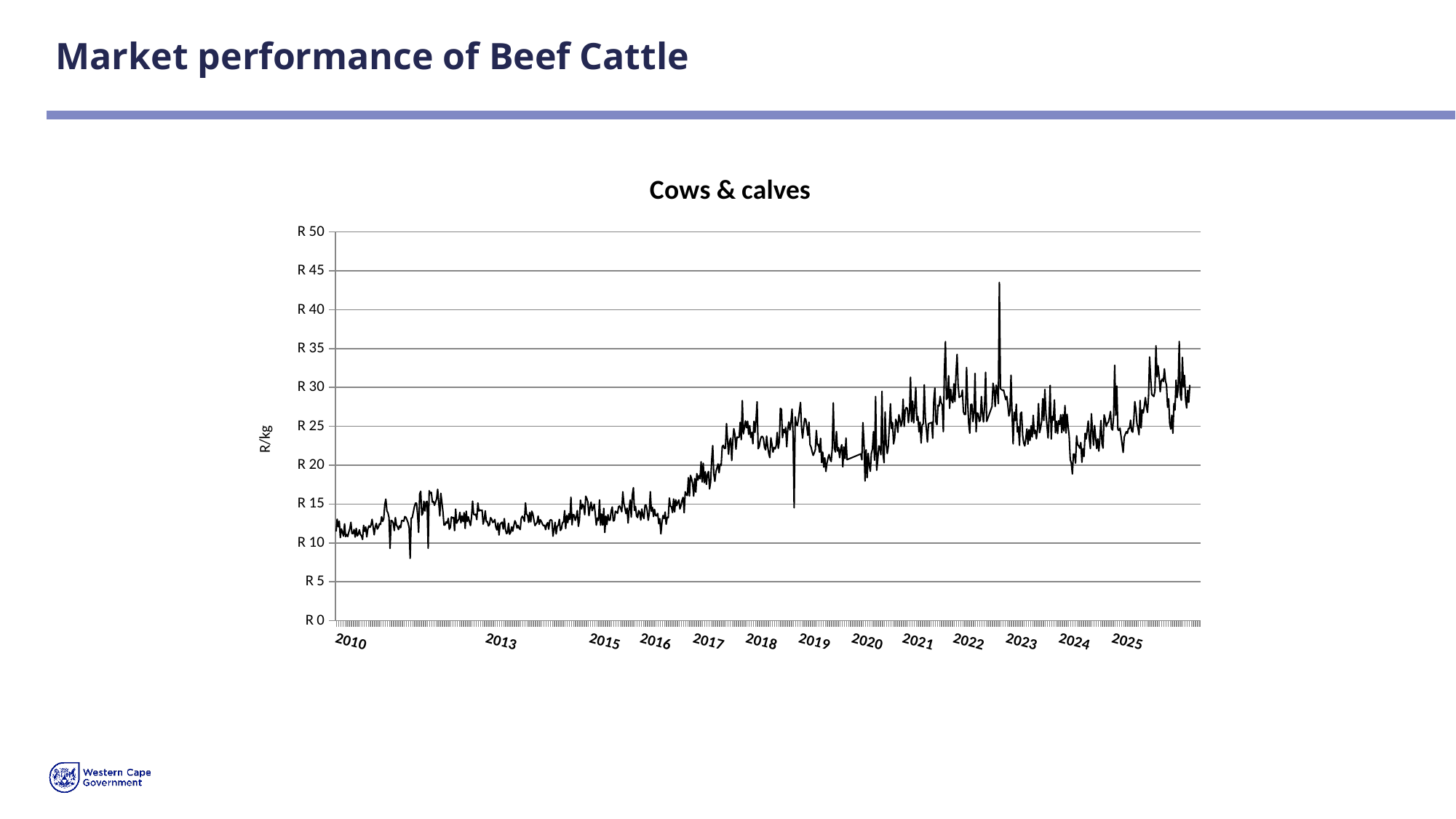
How many year labels are shown along the horizontal axis? 13 Overall, do the values rise or fall from 2010 to 2025? rise What is the label on the vertical axis of the chart? R/kg Is the value at the end of the line in 2025 greater or less than R 40? less What kind of chart is shown on the slide? line chart Is the value at the start of 2010 greater or less than R 10? greater Are the values in 2025 greater or less than R 20? greater What is the title of the chart? Cows & calves What is the highest value shown on the vertical axis? R 50